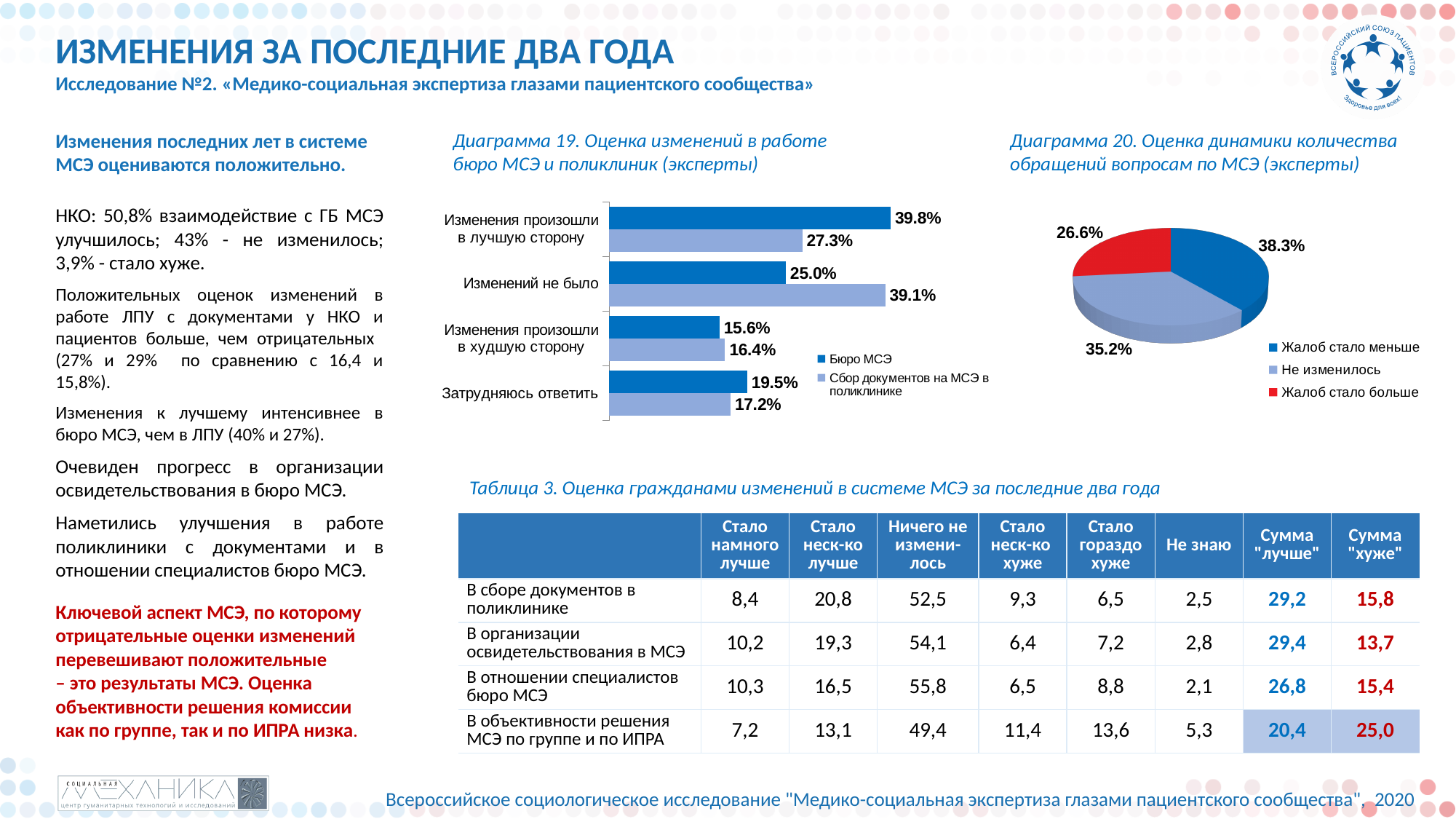
In Диаграмма 19, what is the difference between 'Бюро МСЭ' and 'Сбор документов на МСЭ в поликлинике' in the category 'Изменения произошли в лучшую сторону'? 12.5% In Диаграмма 19, which category has the lowest value for the 'Бюро МСЭ' series? Изменения произошли в худшую сторону In Диаграмма 20, what share of the pie is 'Жалоб стало больше'? 26.6% What type of chart is Диаграмма 20? Pie chart In Диаграмма 19, which category has the highest value for the 'Сбор документов на МСЭ в поликлинике' series? Изменений не было In Диаграмма 19, what is the value for 'Бюро МСЭ' in the category 'Изменения произошли в лучшую сторону'? 39.8% In Диаграмма 19, what is the value for 'Сбор документов на МСЭ в поликлинике' in the category 'Изменений не было'? 39.1% How many categories are shown in Диаграмма 19? 4 How many series does the legend of Диаграмма 19 list? 2 In Диаграмма 19, for the category 'Затрудняюсь ответить', which series has the larger value: 'Бюро МСЭ' or 'Сбор документов на МСЭ в поликлинике'? Бюро МСЭ In Диаграмма 20, which slice is the largest? Жалоб стало меньше What type of chart is Диаграмма 19? Bar chart